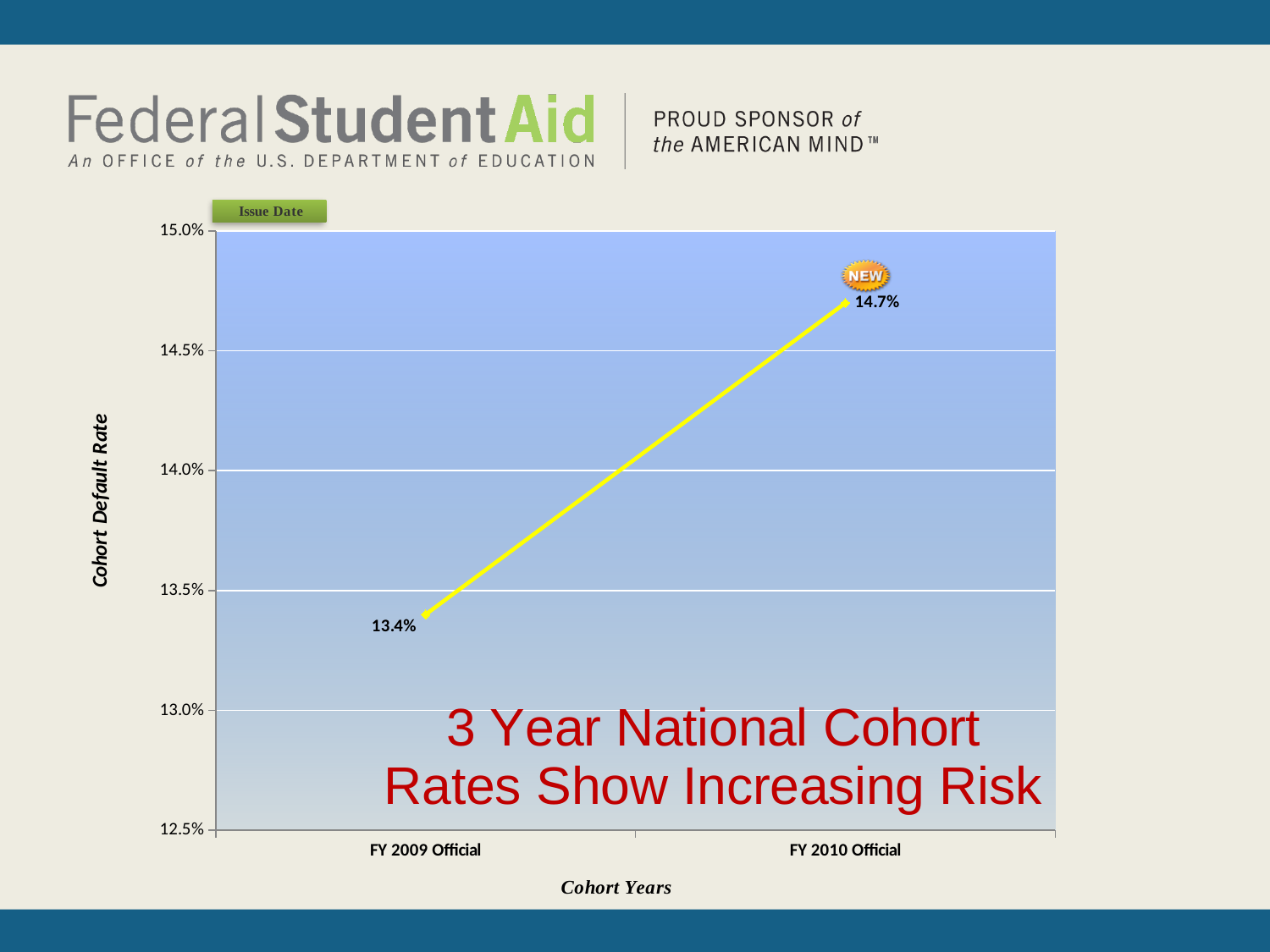
Which cohort year has the higher cohort default rate? FY 2010 Official Is the cohort default rate for FY 2009 Official greater or less than 13.5%? less What is the cohort default rate for FY 2010 Official? 14.7% What is the difference between the FY 2010 Official and FY 2009 Official cohort default rates? 1.3% What is the cohort default rate for FY 2009 Official? 13.4% Is the cohort default rate for FY 2010 Official greater or less than 14.5%? greater What kind of chart is shown on the slide? line chart What is the label of the horizontal axis? Cohort Years How many cohort years are plotted on the chart? 2 What is the label of the vertical axis? Cohort Default Rate Does the cohort default rate rise or fall from FY 2009 Official to FY 2010 Official? rise Which cohort year has the lower cohort default rate? FY 2009 Official